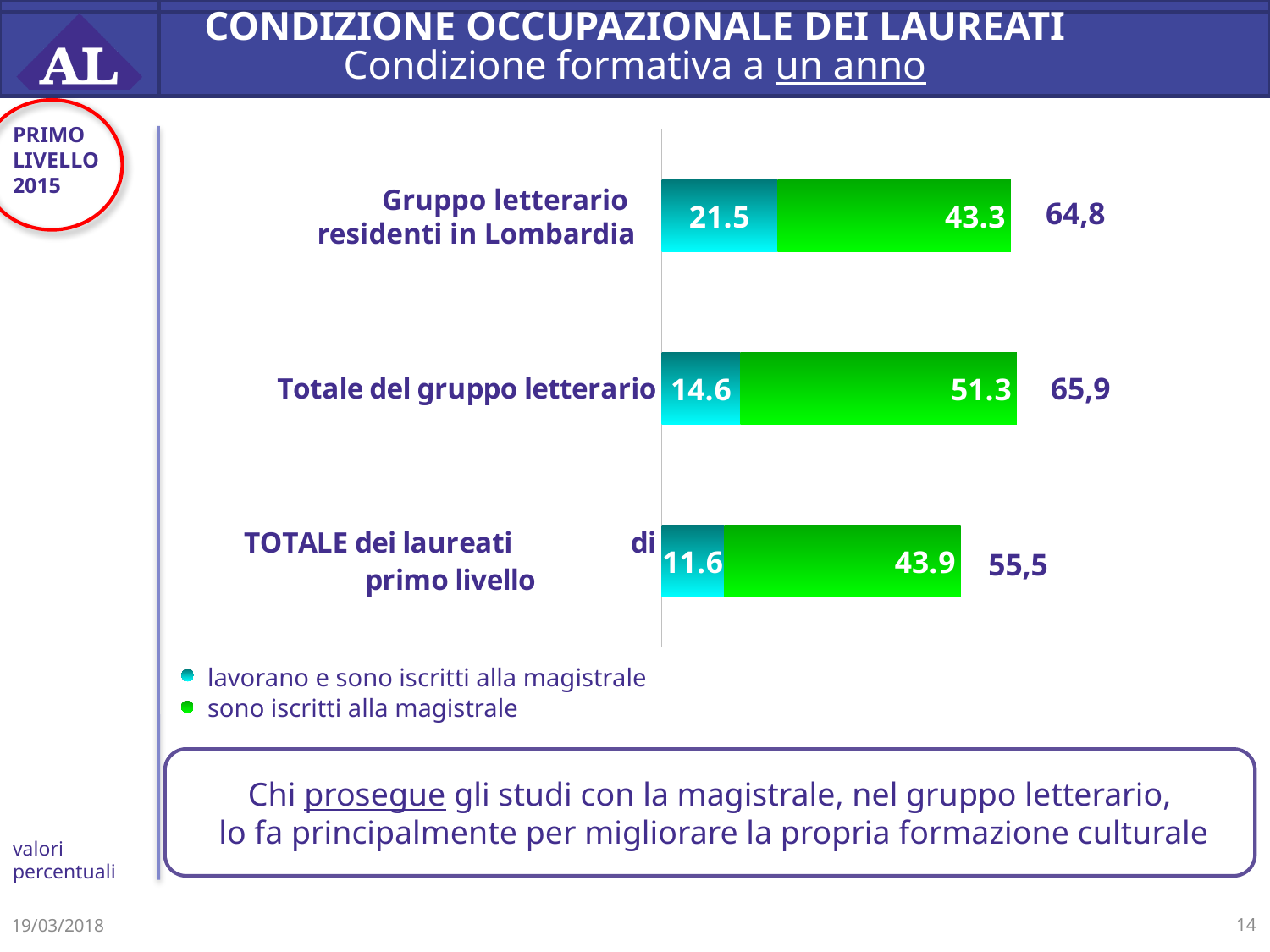
Which legend entry is shown in green? sono iscritti alla magistrale How many categories are plotted in the chart? 3 What is the total shown for the 'Totale del gruppo letterario' bar? 65,9 What is the total shown for the 'TOTALE dei laureati di primo livello' bar? 55,5 What is the value of 'lavorano e sono iscritti alla magistrale' for 'Gruppo letterario residenti in Lombardia'? 21.5 What is the difference between the 'lavorano e sono iscritti alla magistrale' values for 'Gruppo letterario residenti in Lombardia' and 'Totale del gruppo letterario'? 6.9 How many series does the legend list? 2 Which category has the highest value for 'sono iscritti alla magistrale'? Totale del gruppo letterario What type of chart is shown on the slide? Stacked bar chart What is the value of 'lavorano e sono iscritti alla magistrale' for 'TOTALE dei laureati di primo livello'? 11.6 Which category has the lowest value for 'lavorano e sono iscritti alla magistrale'? TOTALE dei laureati di primo livello What is the value of 'sono iscritti alla magistrale' for 'Totale del gruppo letterario'? 51.3